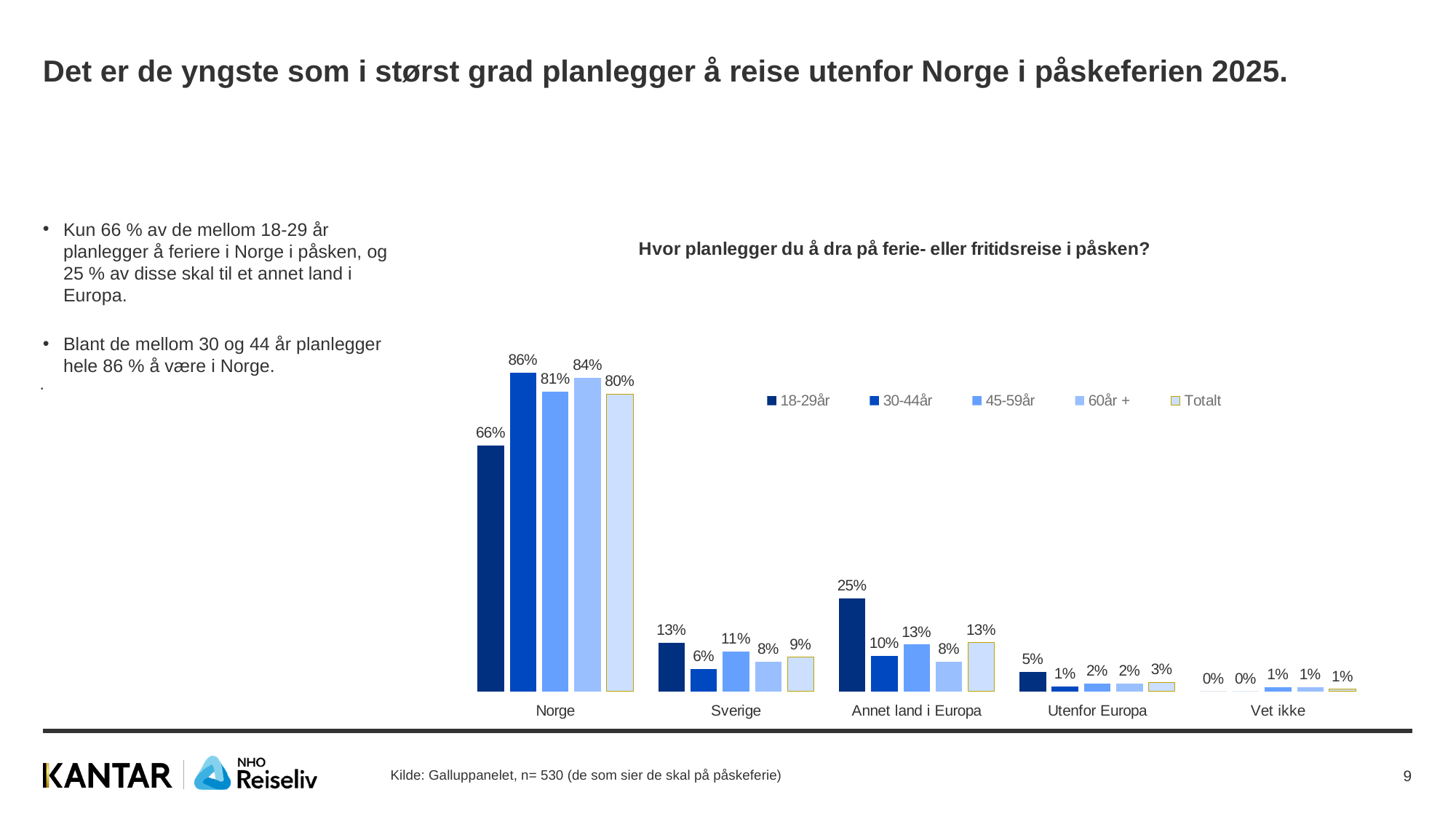
Which age group has the lowest value in the Annet land i Europa category? 60år + Which is larger in the Sverige category: the 18-29år value or the 45-59år value? 18-29år What is the value for the 30-44år series in the Annet land i Europa category? 10% What is the value for the 18-29år series in the Norge category? 66% How many series does the legend list? 5 What is the title of the chart? Hvor planlegger du å dra på ferie- eller fritidsreise i påsken? What is the value for the 18-29år series in the Utenfor Europa category? 5% What kind of chart is shown on the slide? Bar chart How many categories are shown on the x axis? 5 What is the value for the Totalt series in the Sverige category? 9% What is the difference between the 30-44år and 18-29år values in the Norge category? 20% Which age group has the highest value in the Norge category? 30-44år